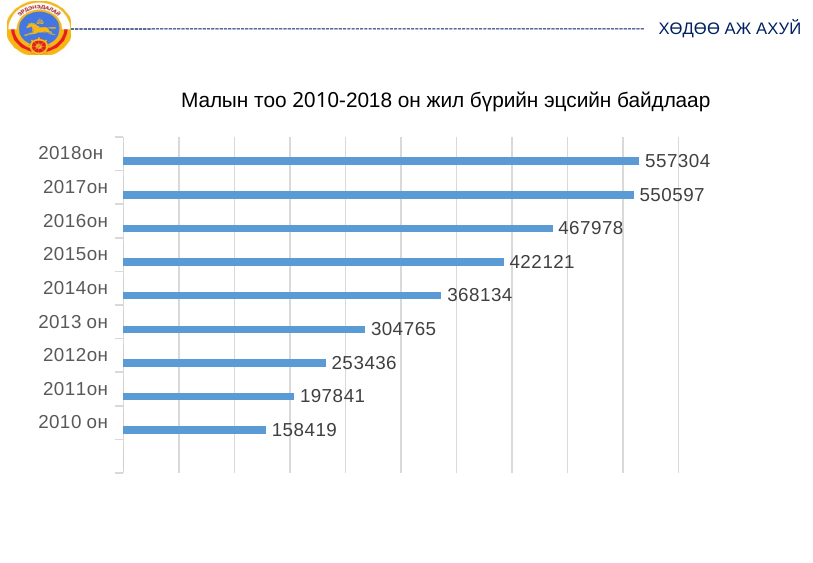
What is the value for 2010 он? 158419 What is the difference between the values for 2018он and 2017он? 6707 What kind of chart is shown on the slide? bar chart What is the title of the chart? Малын тоо 2010-2018 он жил бүрийн эцсийн байдлаар Which is larger, the value for 2013 он or the value for 2012он? 2013 он Which year has the lowest value? 2010 он What is the difference between the values for 2016он and 2015он? 45857 What is the value for 2014он? 368134 Do the values rise or fall from 2010 он to 2018он? rise How many years are shown in the chart? 9 Which year has the highest value? 2018он What is the value for 2018он? 557304